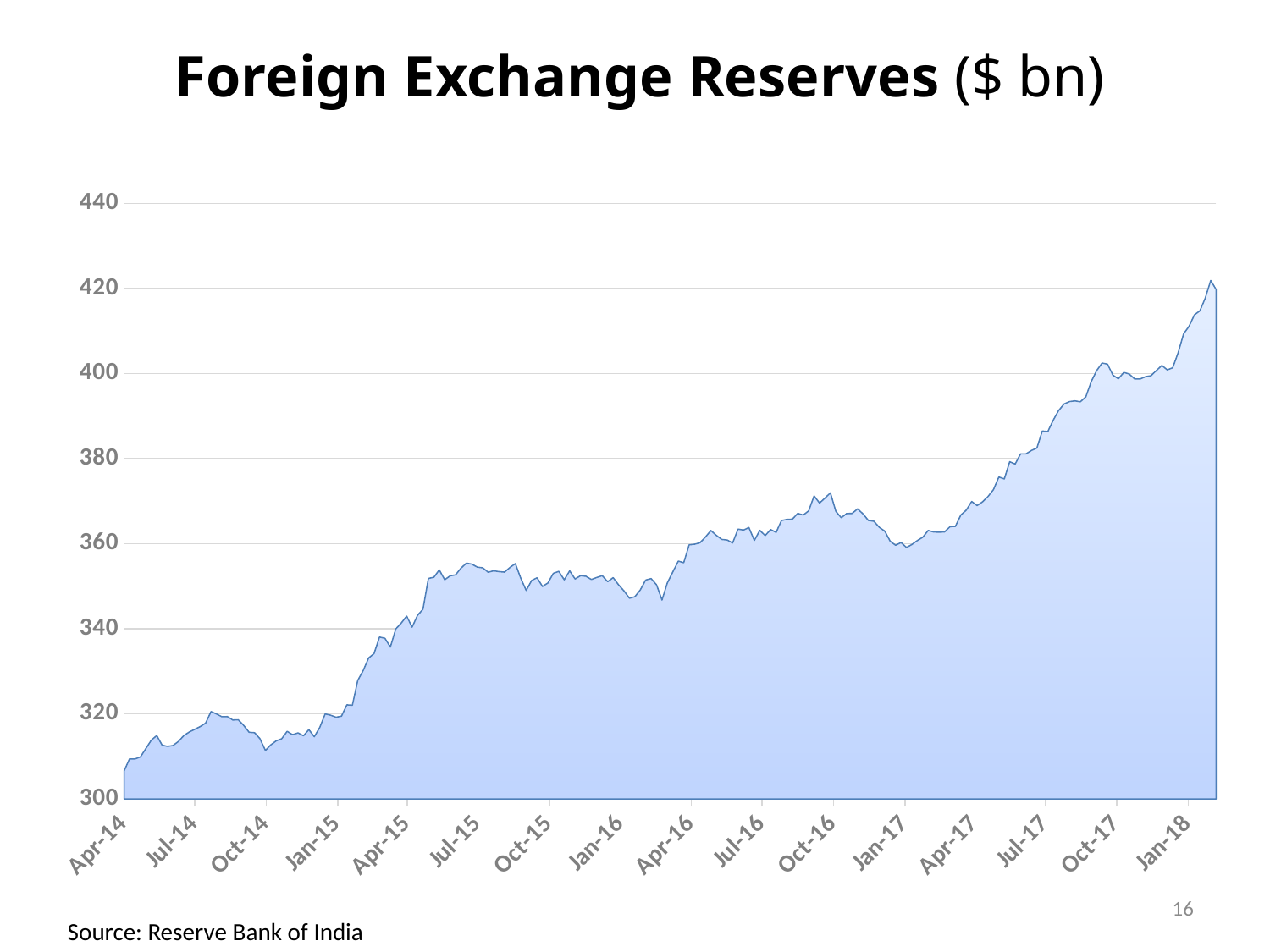
Is the value for Jan-16 greater or less than 360? less Is the value for Jan-18 greater or less than 380? greater Is the value for Jul-15 greater or less than 340? greater What kind of chart is shown on the slide? Area chart Do foreign exchange reserves generally rise or fall from Apr-14 to Jan-18? Rise What is the title of the chart? Foreign Exchange Reserves ($ bn) How many date labels are shown on the x axis? 16 What source is cited for the chart data? Reserve Bank of India